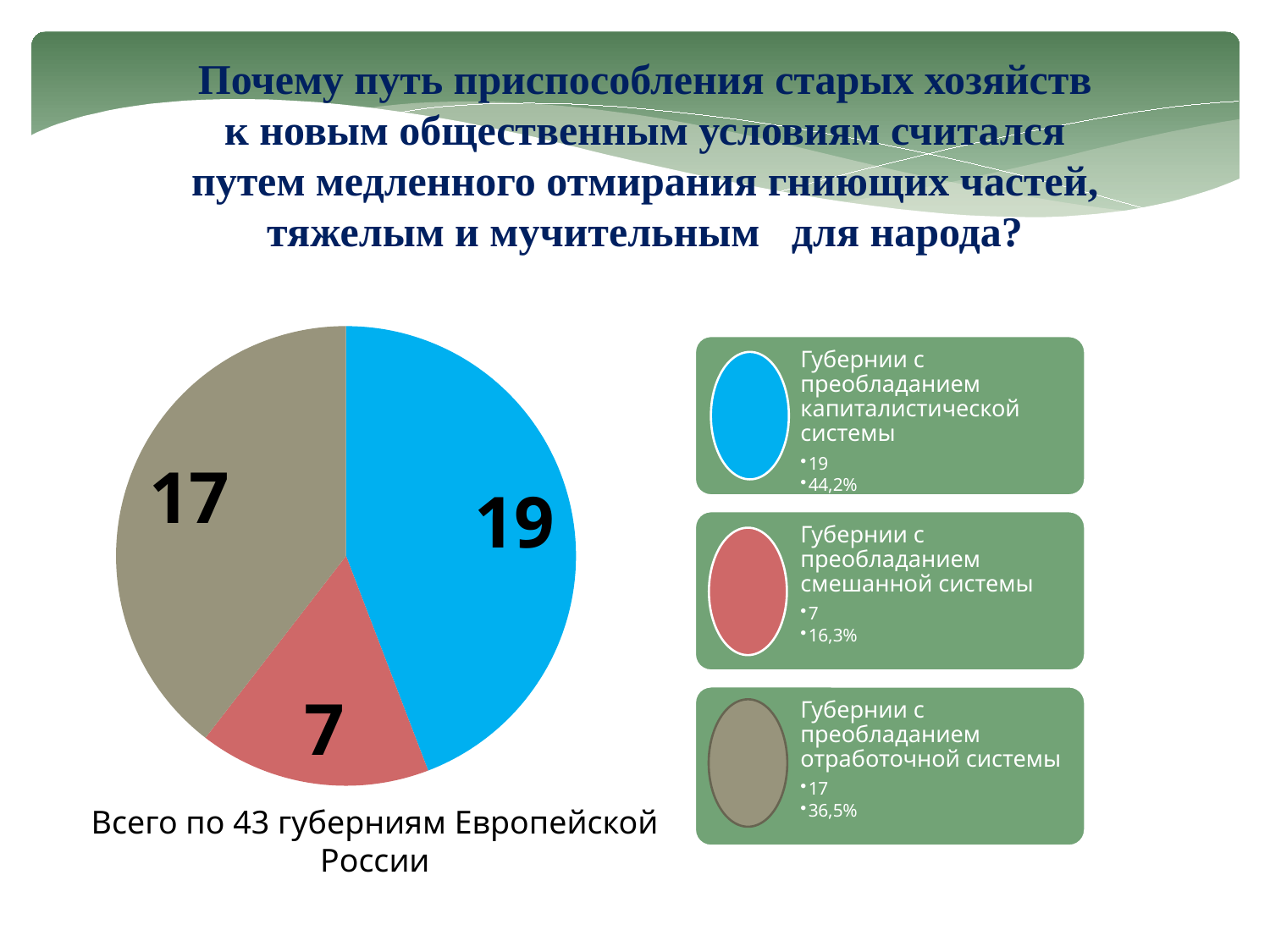
According to the caption under the pie chart, how many provinces of European Russia are covered in total? 43 Which is larger: the value for the capitalist-system provinces or the otrabotochnaya-system provinces? Губернии с преобладанием капиталистической системы What share of the pie do the capitalist-system provinces represent, as printed on the slide? 44,2% What is the value of the red slice (губернии с преобладанием смешанной системы)? 7 What is the value of the blue slice (губернии с преобладанием капиталистической системы)? 19 What is the difference between the value for the capitalist-system provinces and the mixed-system provinces? 12 What type of chart is shown on the slide? pie chart Which category has the smallest slice in the pie chart? Губернии с преобладанием смешанной системы How many slices does the pie chart have? 3 What is the value of the grey-brown slice (губернии с преобладанием отработочной системы)? 17 What share of the pie do the mixed-system provinces represent, as printed on the slide? 16,3% Which category has the largest slice in the pie chart? Губернии с преобладанием капиталистической системы